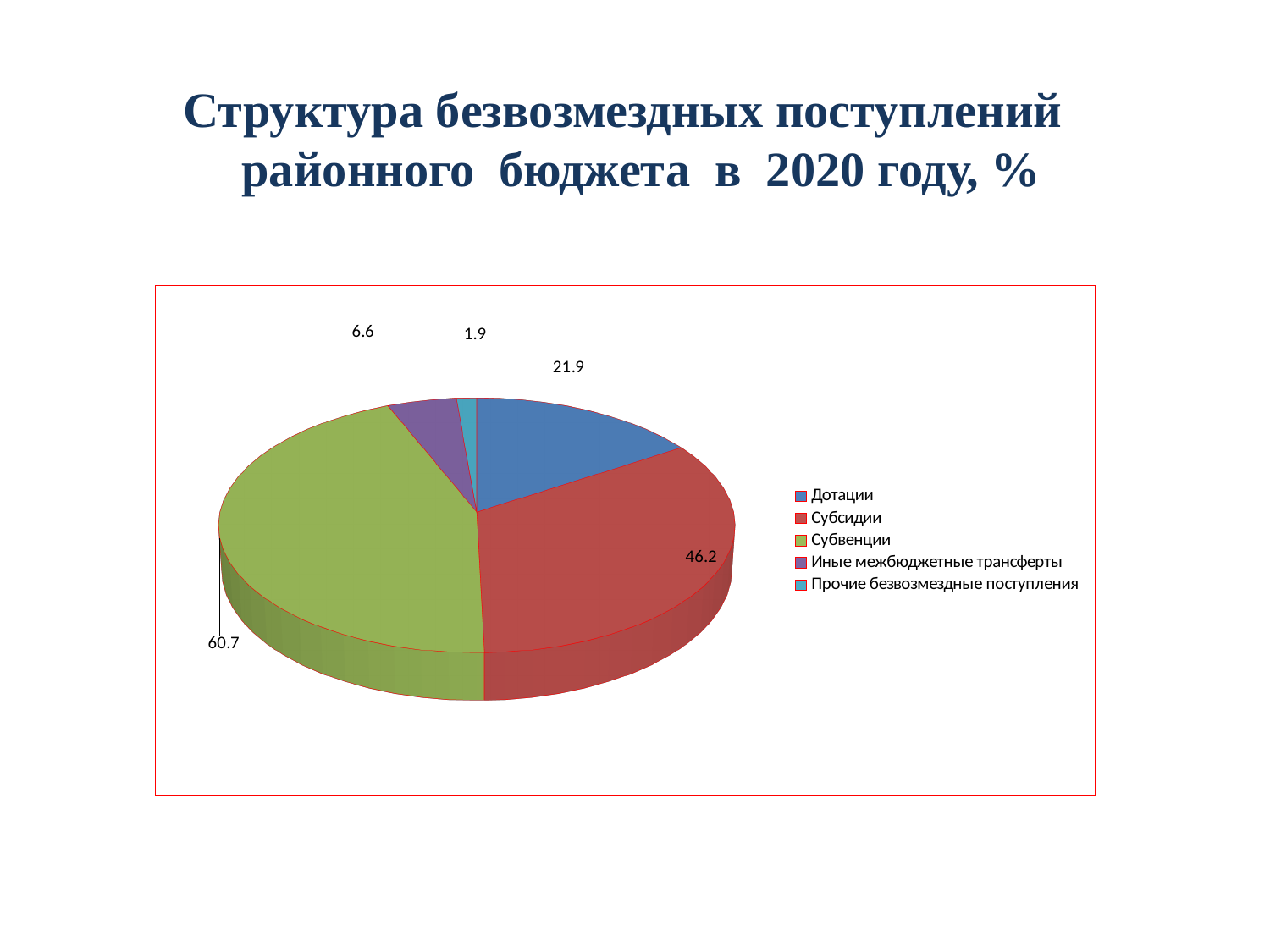
What value is shown for Субсидии? 46.2 What value is shown for Дотации? 21.9 What value is shown for Прочие безвозмездные поступления? 1.9 What is the difference between the values for Субвенции and Субсидии? 14.5 What kind of chart is shown on the slide? Pie chart Which category has the smallest slice? Прочие безвозмездные поступления What value is shown for Иные межбюджетные трансферты? 6.6 How many categories does the pie chart show? 5 What value is shown for Субвенции? 60.7 Which is larger, Дотации or Иные межбюджетные трансферты? Дотации What colour is the slice for Субсидии? Red Which category has the largest slice? Субвенции